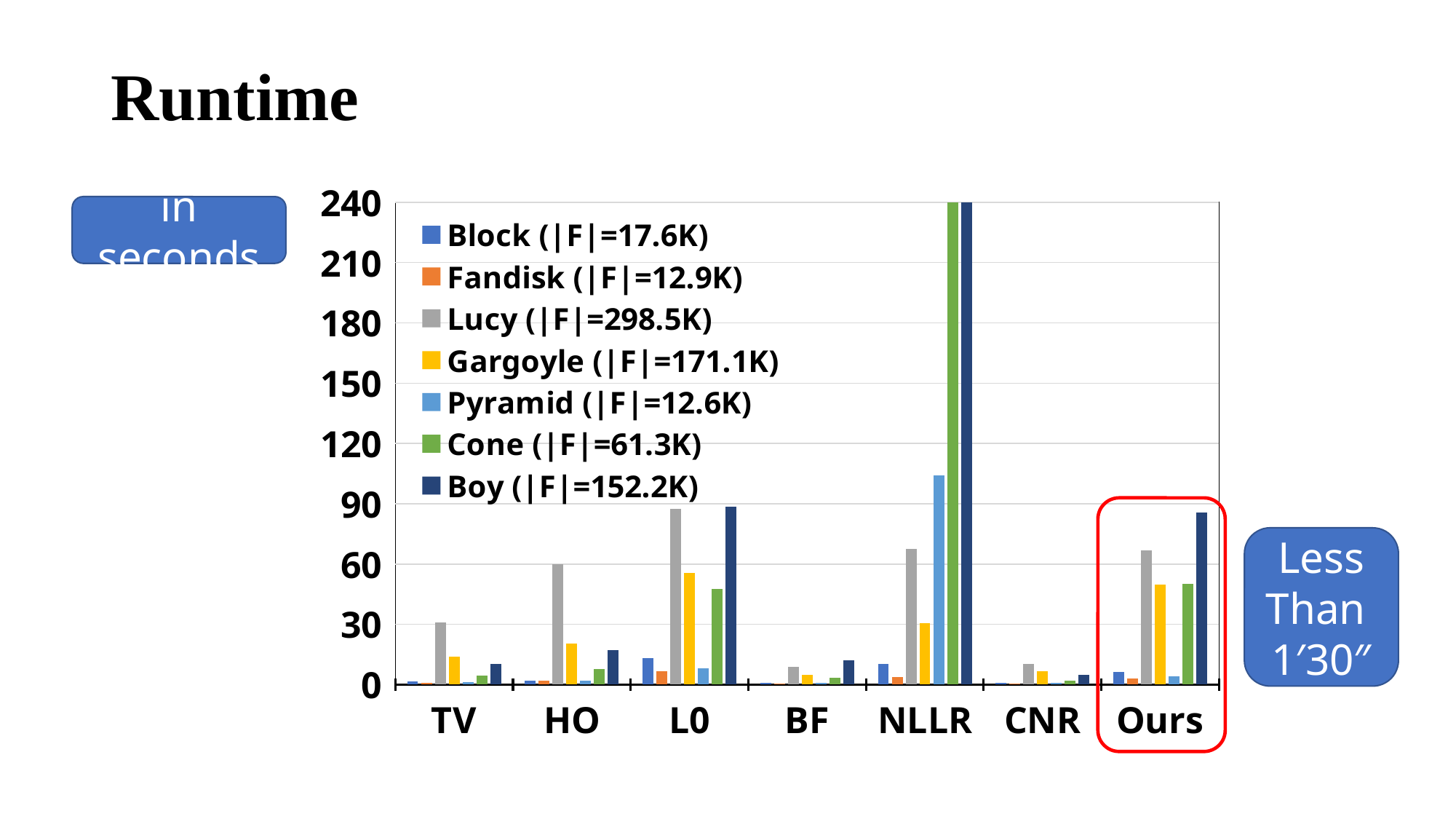
How many series does the legend list? 7 Is the Gargoyle value for Ours greater or less than 60? less Is the Lucy value for L0 greater or less than 60? greater Which is larger: the Boy value for NLLR or the Boy value for CNR? NLLR What kind of chart is shown on the slide? bar chart For the Ours category, which series has the tallest bar? Boy How many methods (categories) are shown along the x axis? 7 Is the Pyramid value for NLLR greater or less than 90? greater Which method has the highest Boy value? NLLR Which is larger: the Lucy value for L0 or the Lucy value for TV? L0 According to the legend, what is the face count |F| for the Lucy model? 298.5K